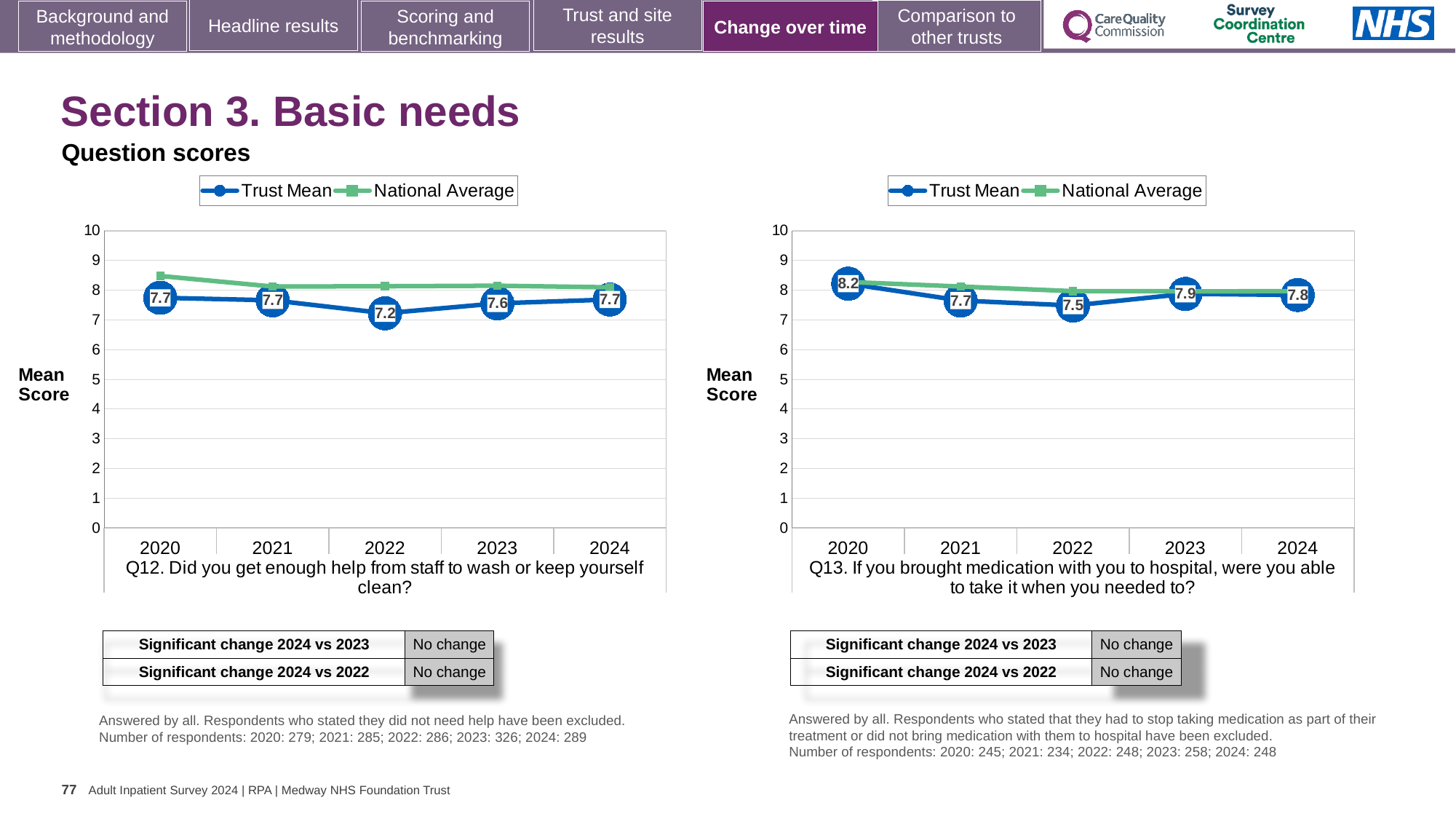
In the Q13 chart (right), is the Trust Mean score higher in 2023 or in 2024? 2023 How many years are shown on the x axis of the Q12 chart (left)? 5 In the Q13 chart (right), what is the difference between the Trust Mean scores for 2020 and 2022? 0.7 In the Q13 chart (right), which year has the highest Trust Mean score? 2020 In the Q12 chart (left), what is the difference between the Trust Mean scores for 2024 and 2022? 0.5 In the Q12 chart (left), which year has the lowest Trust Mean score? 2022 How many series does the legend of the Q13 chart (right) list? 2 In the Q13 chart (right), which year has the lowest Trust Mean score? 2022 In the Q12 chart (left), is the National Average value for 2020 greater or less than 8? greater In the Q13 chart (right), what is the Trust Mean score for 2024? 7.8 In the Q13 chart (right), what is the Trust Mean score for 2020? 8.2 In the Q12 chart (left), what is the Trust Mean score for 2022? 7.2